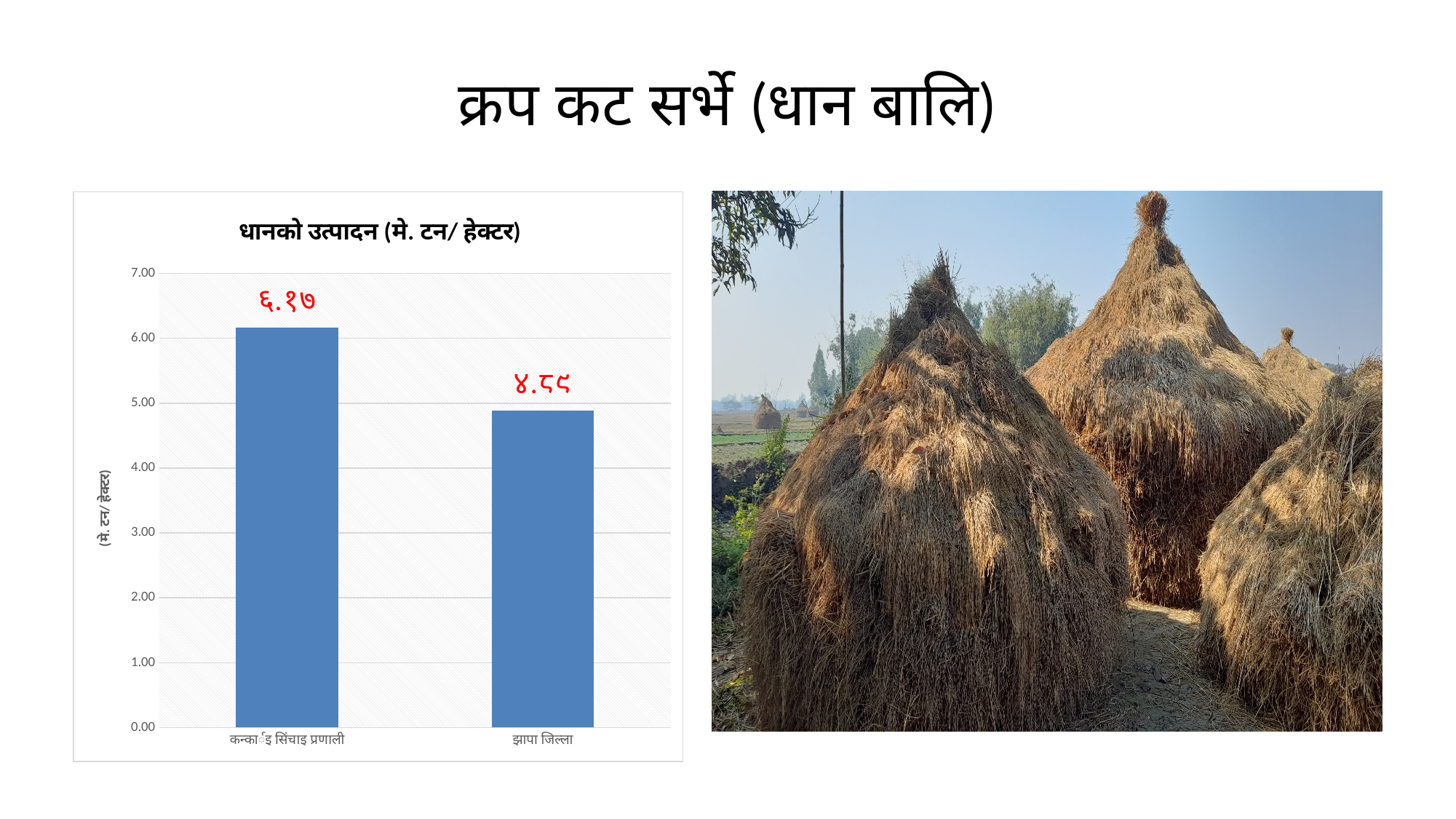
What is the title of the chart? धानको उत्पादन (मे. टन/ हेक्टर) What kind of chart is shown on the slide? bar chart What is the label on the vertical axis of the chart? (मे. टन/ हेक्टर) How many categories are plotted in the chart? 2 What is the difference between the values for कन्काई सिंचाइ प्रणाली and झापा जिल्ला? १.२८ What is the value shown for झापा जिल्ला in the chart? ४.८९ Is the value for झापा जिल्ला greater or less than 5.00? less Which category has the lowest value in the chart? झापा जिल्ला Which category has the highest value in the chart? कन्काई सिंचाइ प्रणाली What is the value shown for कन्काई सिंचाइ प्रणाली in the chart? ६.१७ Is the value for कन्काई सिंचाइ प्रणाली greater or less than 6.00? greater Which is larger, the value for कन्काई सिंचाइ प्रणाली or the value for झापा जिल्ला? कन्काई सिंचाइ प्रणाली